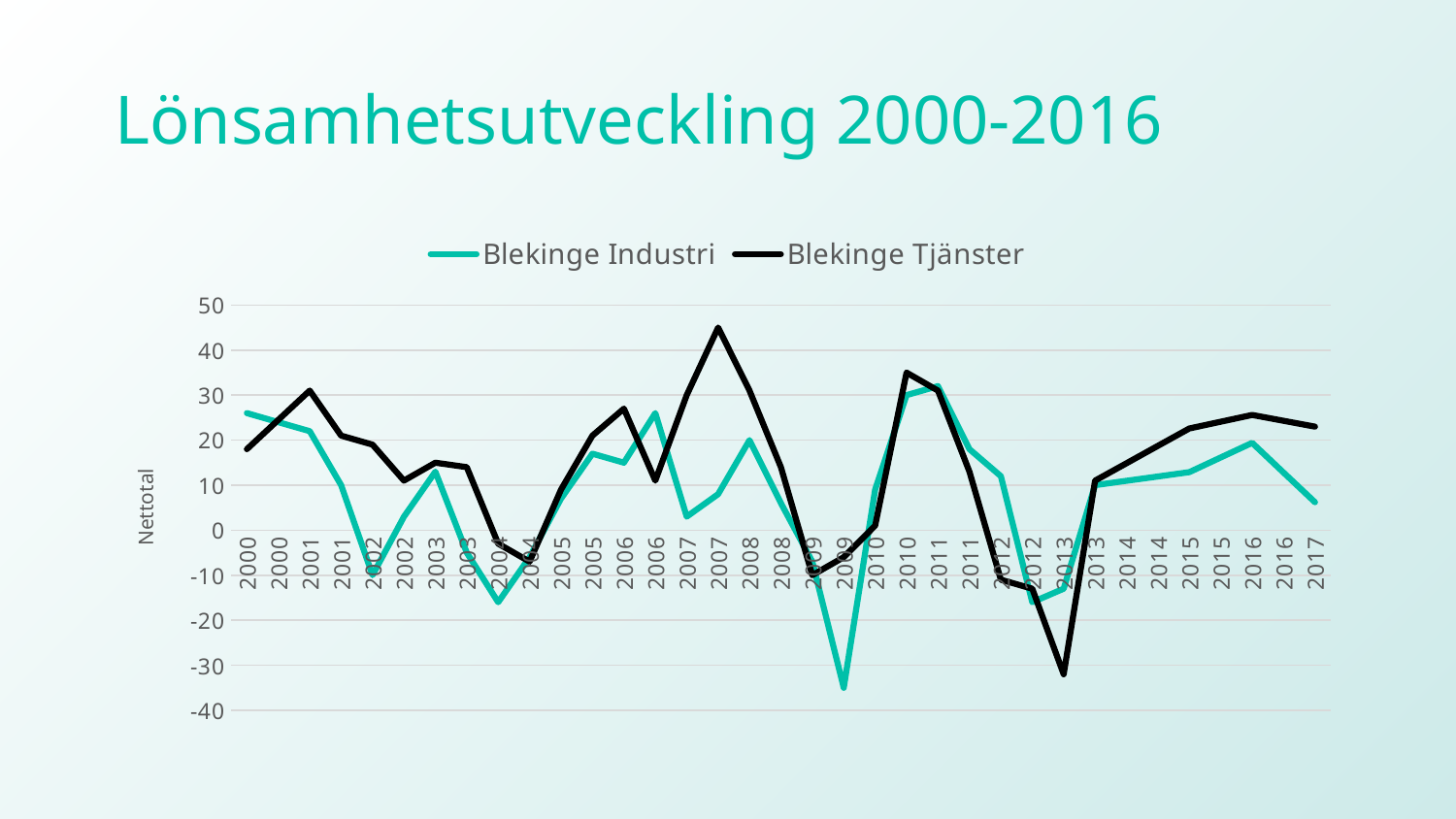
Is the value for Blekinge Tjänster at 2017 greater or less than 20? greater Is the value for Blekinge Industri at 2017 greater or less than 10? less What label is shown on the vertical axis? Nettotal In which year does Blekinge Tjänster reach its highest value? 2007 What is the title of the chart on the slide? Lönsamhetsutveckling 2000-2016 Does the Blekinge Tjänster line rise or fall from 2013 to 2016? rise Is the lowest value of Blekinge Industri (in 2009) greater or less than -30? less At 2017, which series has the higher value, Blekinge Industri or Blekinge Tjänster? Blekinge Tjänster What kind of chart is shown on the slide? Line chart In which year does Blekinge Industri reach its lowest value? 2009 How many series does the legend list? 2